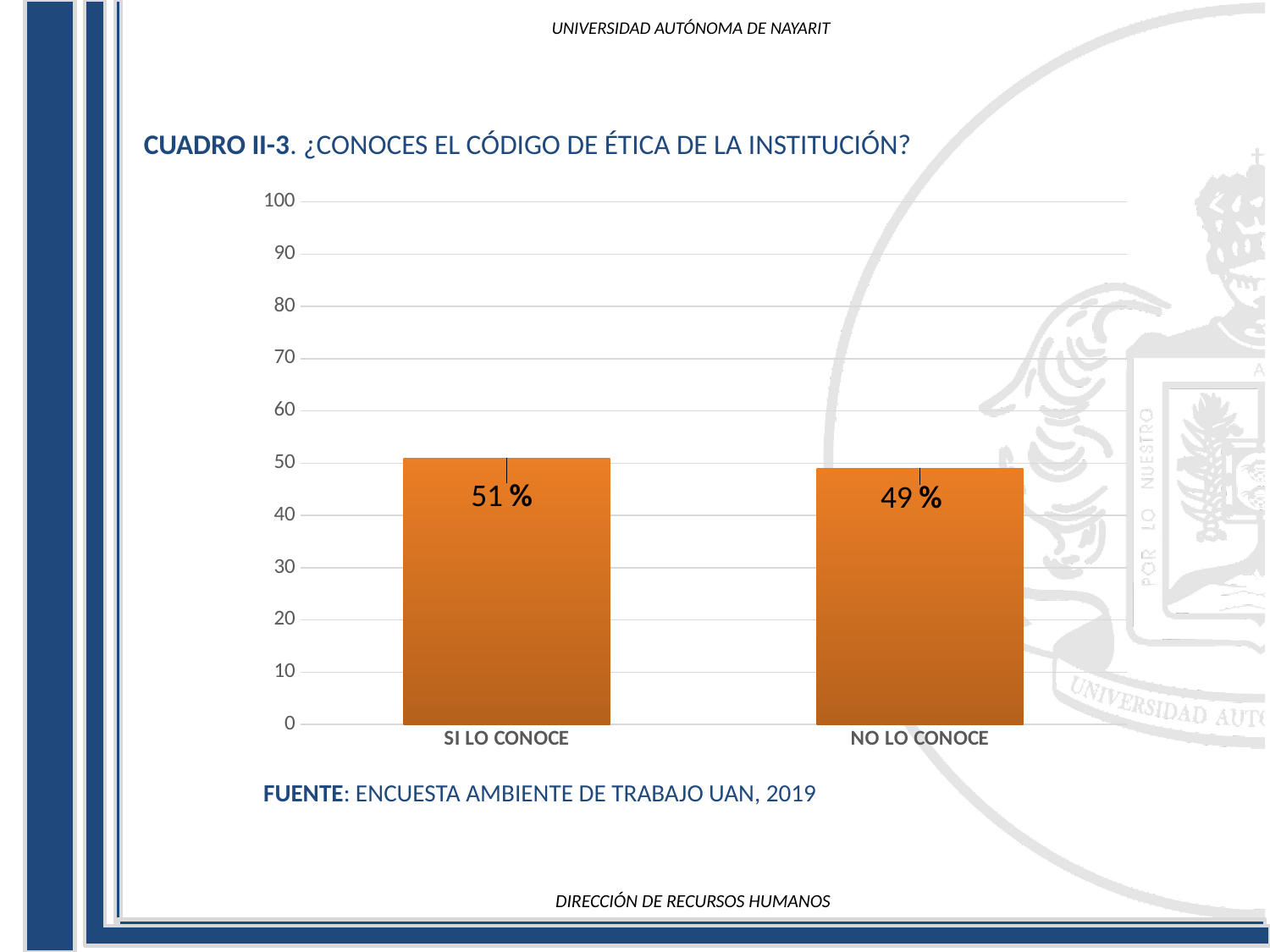
Which category has the higher value? SI LO CONOCE Is the value for SI LO CONOCE greater or less than 50? greater What is the difference between the values for SI LO CONOCE and NO LO CONOCE? 2 % What is the value for SI LO CONOCE? 51 % What is the source cited below the chart? ENCUESTA AMBIENTE DE TRABAJO UAN, 2019 What is the value for NO LO CONOCE? 49 % Which category has the lower value? NO LO CONOCE How many categories are shown on the x axis? 2 What kind of chart is shown on the slide? bar chart Is the value for NO LO CONOCE greater or less than 50? less What is the highest value shown on the y axis? 100